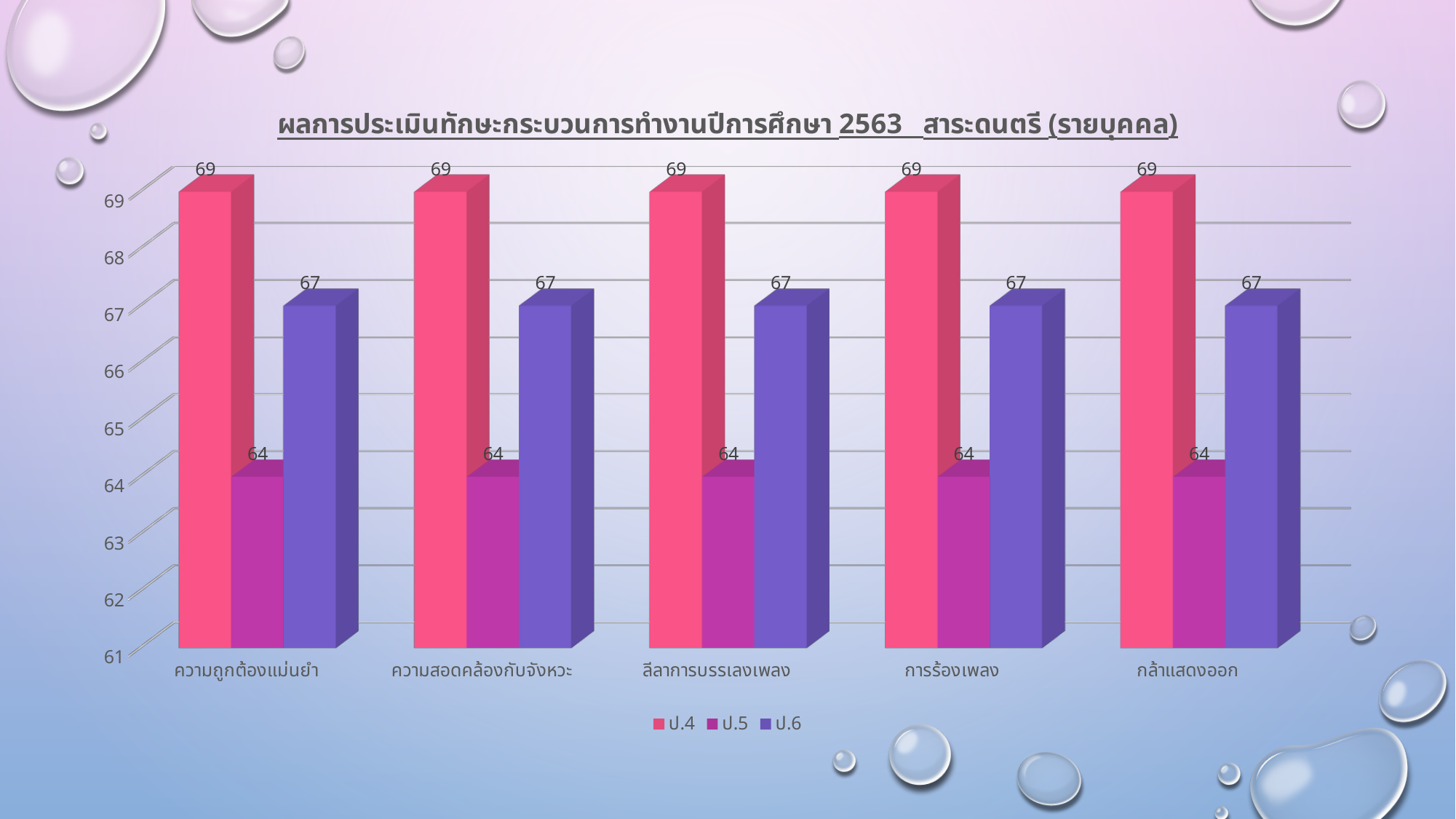
What is the value for ป.6 in the category กล้าแสดงออก? 67 Do the values for ป.4 rise, fall, or stay the same across the categories? Stay the same What is the difference between the ป.4 and ป.5 values in the category กล้าแสดงออก? 5 What is the value for ป.5 in the category การร้องเพลง? 64 Which is larger in the category การร้องเพลง: the value for ป.5 or the value for ป.6? ป.6 How many categories are shown on the x axis? 5 What kind of chart is shown on the slide? Bar chart What is the difference between the ป.6 and ป.5 values in the category ความถูกต้องแม่นยำ? 3 Which series has the lowest value in the category ความสอดคล้องกับจังหวะ? ป.5 How many series does the legend list? 3 What is the value for ป.4 in the category ความถูกต้องแม่นยำ? 69 Which series has the highest value in the category ลีลาการบรรเลงเพลง? ป.4